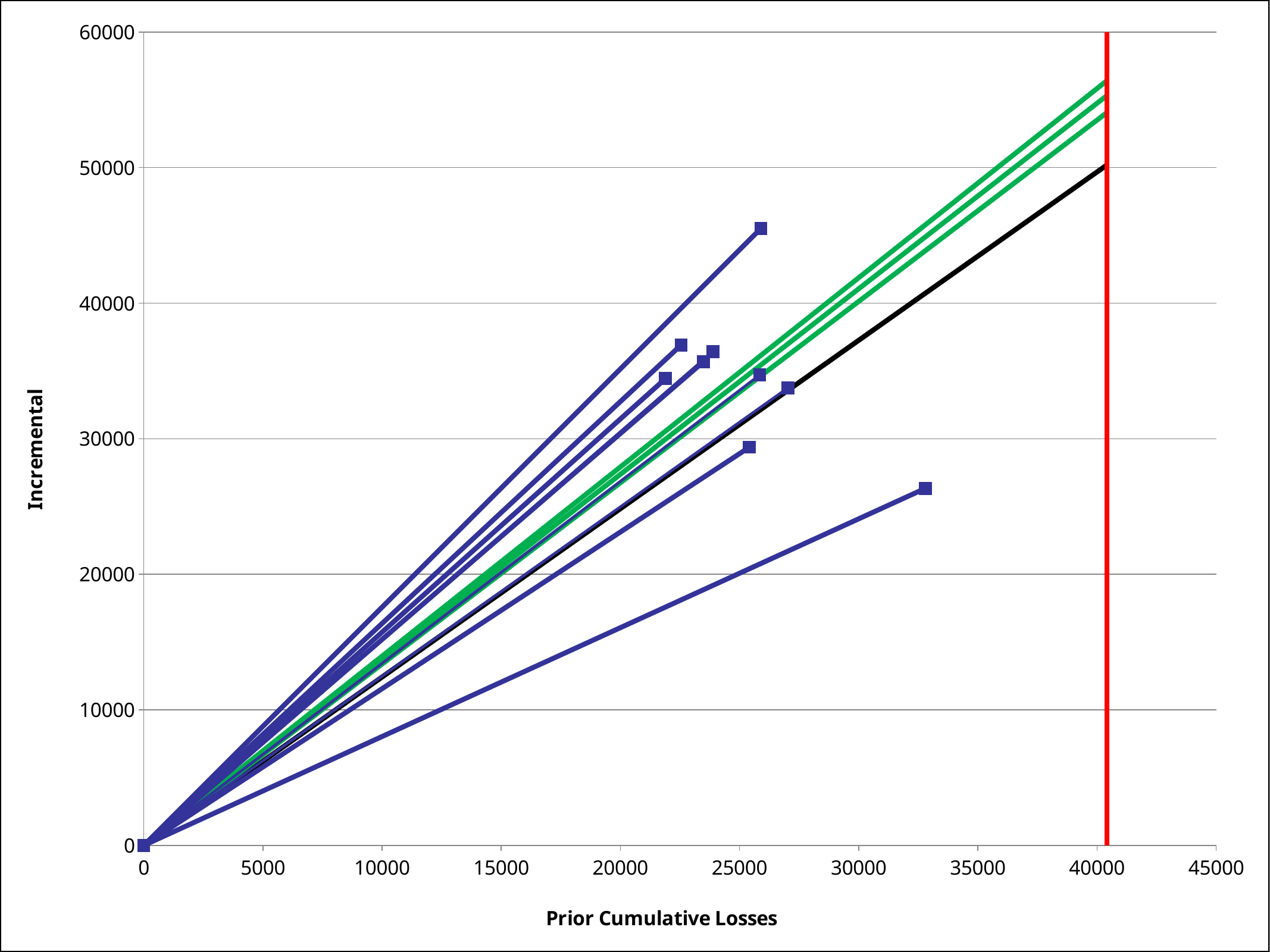
Is the Incremental value of the highest blue marker greater or less than 40000? greater Do the blue lines rise or fall as Prior Cumulative Losses increases? rise What kind of chart is shown on the slide? line chart How many green lines are drawn on the chart? 3 Is the Incremental value of the lowest blue marker greater or less than 30000? less At the red vertical line, which reaches a higher Incremental value: the green lines or the black line? the green lines How many blue square markers are plotted away from the origin? 9 What is the label of the x axis? Prior Cumulative Losses What is the label of the y axis? Incremental Which has the higher Incremental value: the rightmost blue marker or the topmost blue marker? the topmost blue marker Is the Prior Cumulative Losses value of the rightmost blue marker greater or less than 30000? greater